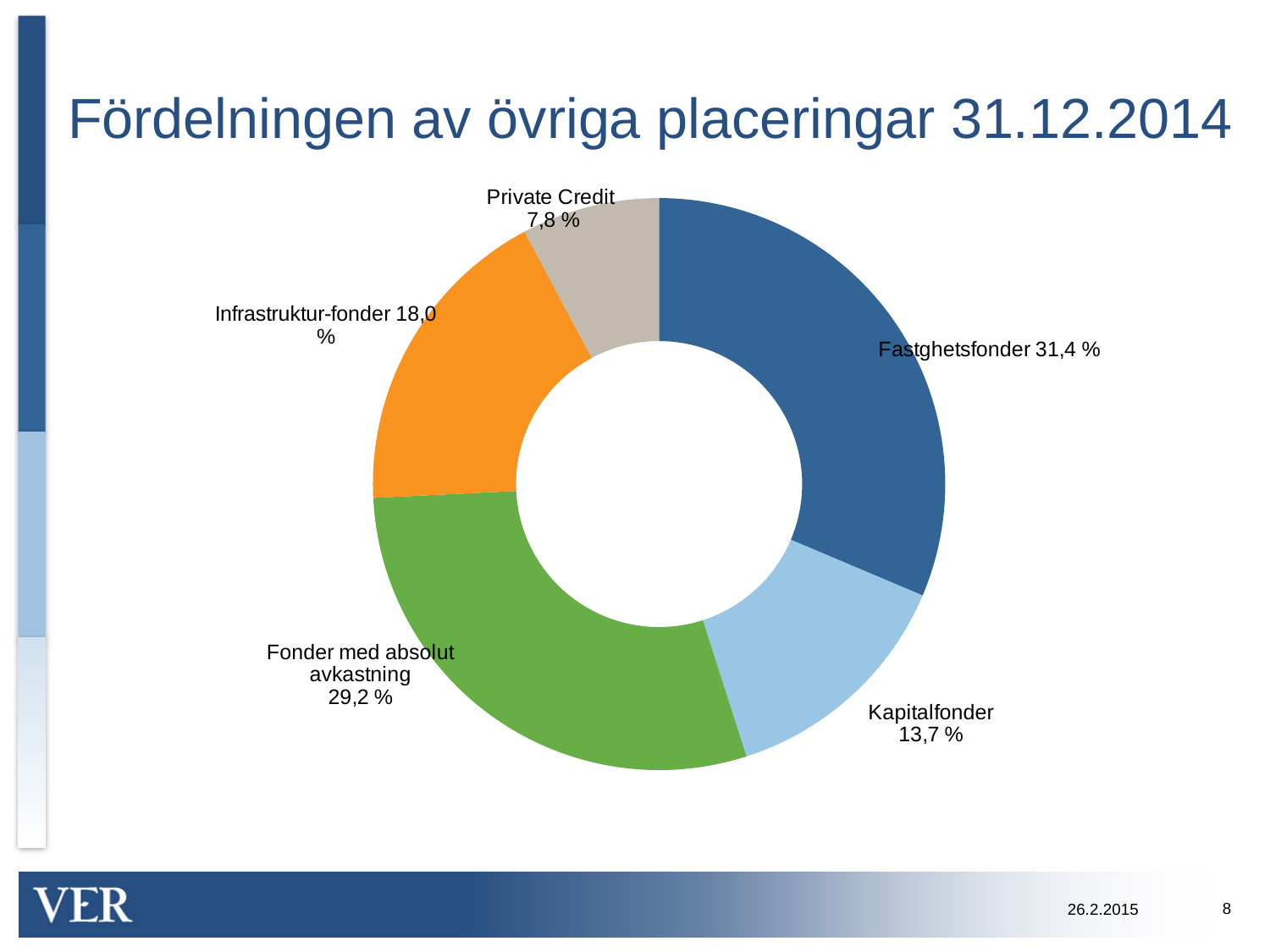
What percentage is shown for Fonder med absolut avkastning? 29,2 % How many categories are shown in the chart? 5 What share is shown for Infrastruktur-fonder? 18,0 % What is the difference in percentage points between Fastghetsfonder and Fonder med absolut avkastning? 2,2 % What is the value for Private Credit? 7,8 % What is the difference between Infrastruktur-fonder and Kapitalfonder? 4,3 % Which category has the smallest share of the chart? Private Credit Which is larger, Infrastruktur-fonder or Kapitalfonder? Infrastruktur-fonder Which category has the largest share of the chart? Fastghetsfonder What is the value shown for Kapitalfonder? 13,7 % What kind of chart is shown on the slide? doughnut chart What share of the chart does Fastghetsfonder represent? 31,4 %